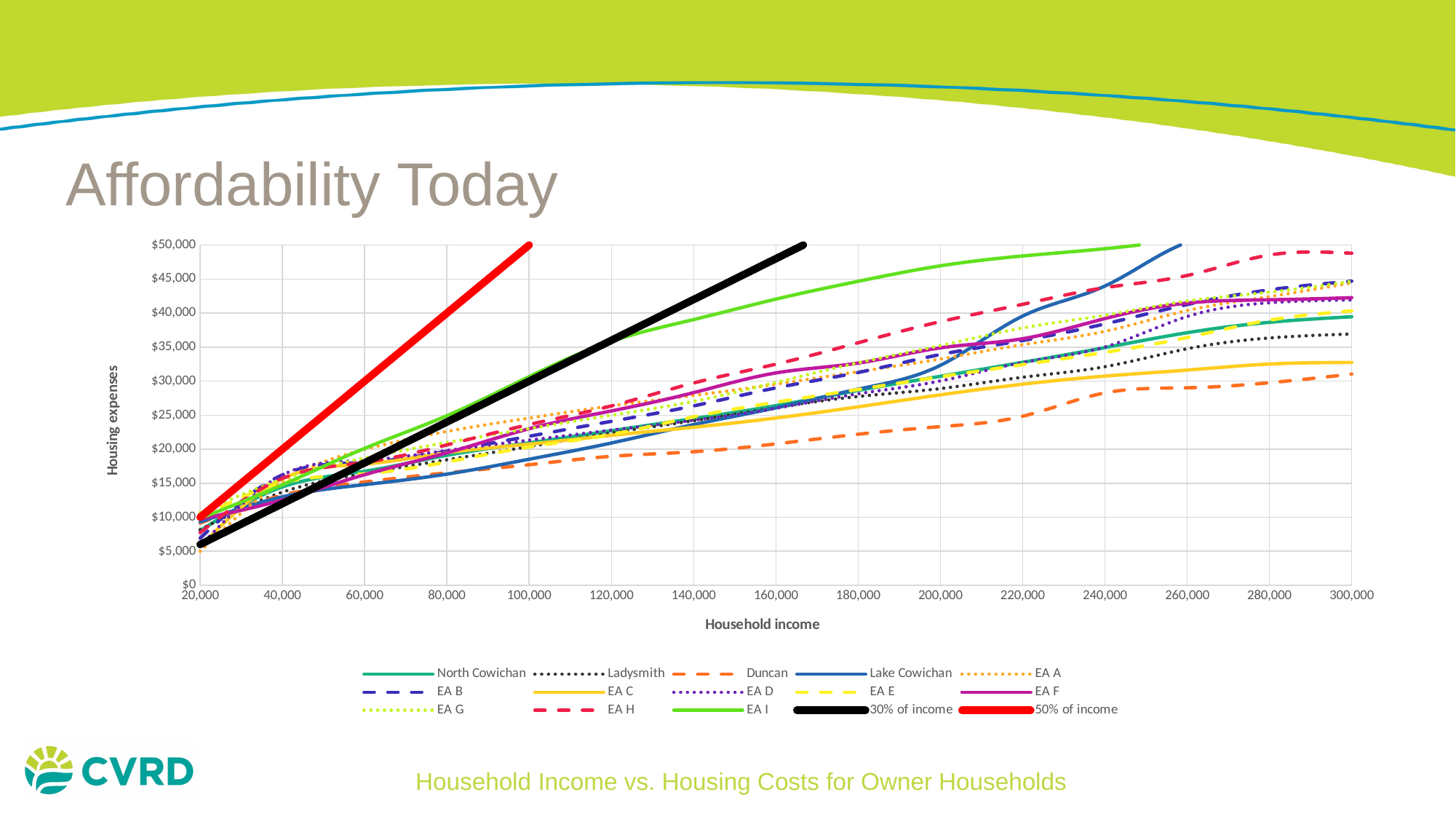
At a household income of 300,000, which series has higher housing expenses, Ladysmith or EA C? Ladysmith Do housing expenses for Duncan rise or fall as household income increases? rise What is the label of the chart's y axis? Housing expenses At a household income of 300,000, which series has higher housing expenses, EA H or Duncan? EA H Is the value for EA I at a household income of 140,000 greater or less than $35,000? greater At what household income does the 50% of income line reach $50,000? 100,000 How many series does the chart legend list? 15 What is the label of the chart's x axis? Household income Is the value for Duncan at a household income of 200,000 greater or less than $25,000? less What kind of chart is shown on the slide? Line chart Which series has the lowest housing expenses at a household income of 300,000? Duncan Is the value for EA H at a household income of 300,000 greater or less than $45,000? greater